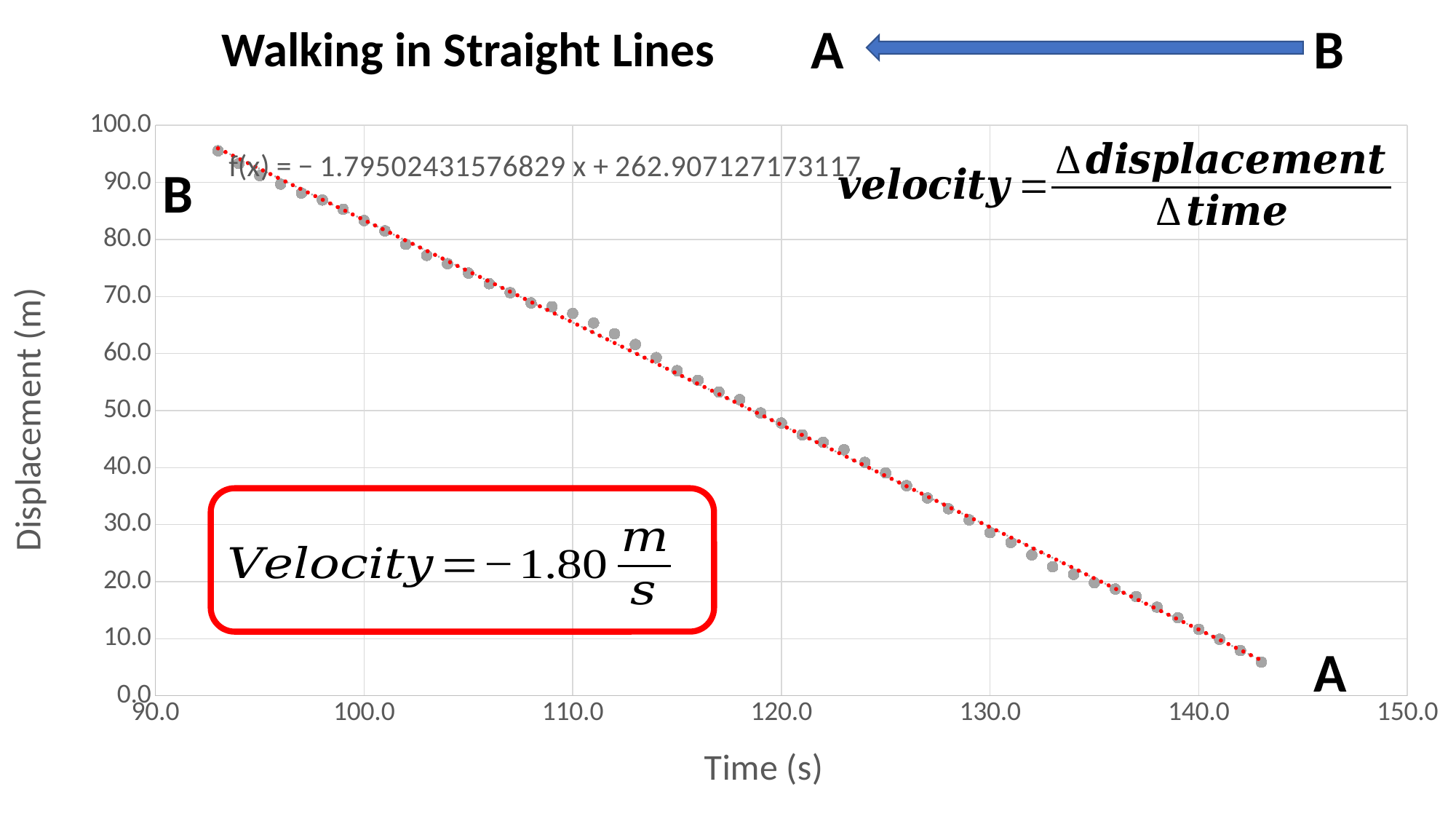
What kind of chart is shown on the slide? scatter chart Is the displacement at a time of 100.0 s greater or less than 80? greater Is the displacement at a time of 140.0 s greater or less than 10? greater What is the label of the x axis? Time (s) What is the intercept of the trendline equation printed on the chart? 262.907127173117 What is the slope of the trendline equation printed on the chart? -1.79502431576829 Is the displacement at a time of 110.0 s greater or less than 70? less What velocity value is given in the red box on the chart? -1.80 m/s What is the title of the chart? Walking in Straight Lines Do the displacement values rise or fall as time increases along the x axis? fall